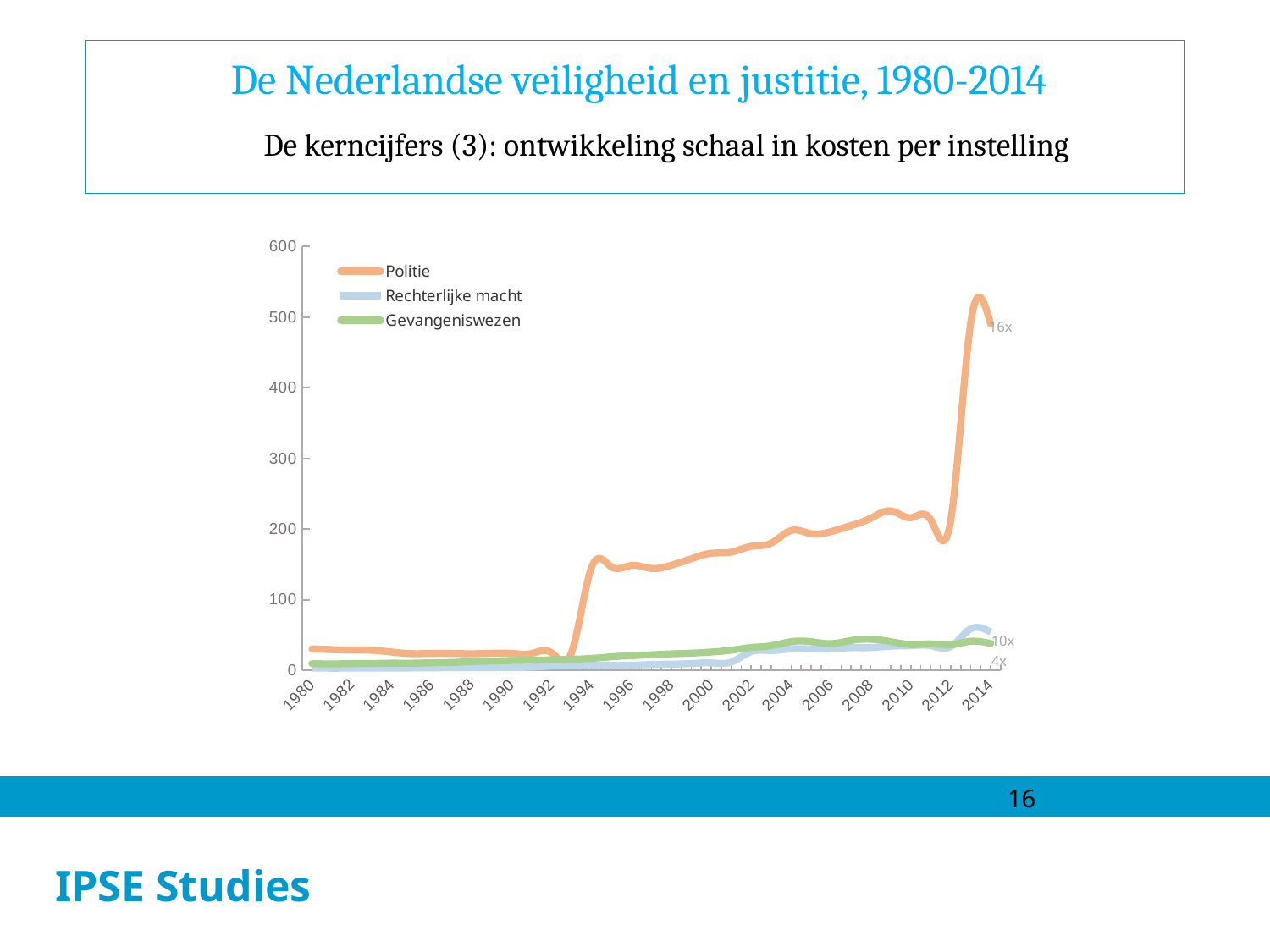
Which series are listed in the legend? Politie, Rechterlijke macht, Gevangeniswezen Is the value for Politie in 2000 greater or less than 100? greater Which multiplier annotation is shown at the end of the Politie line? 16x How many year labels are shown on the x axis? 18 How many series does the legend list? 3 Does the Politie series rise or fall overall from 1980 to 2014? rise Is the value for Rechterlijke macht in 2014 greater or less than 100? less Which series has the highest value in 2014? Politie What kind of chart is shown on the slide? line chart Is the value for Politie in 1990 greater or less than 100? less